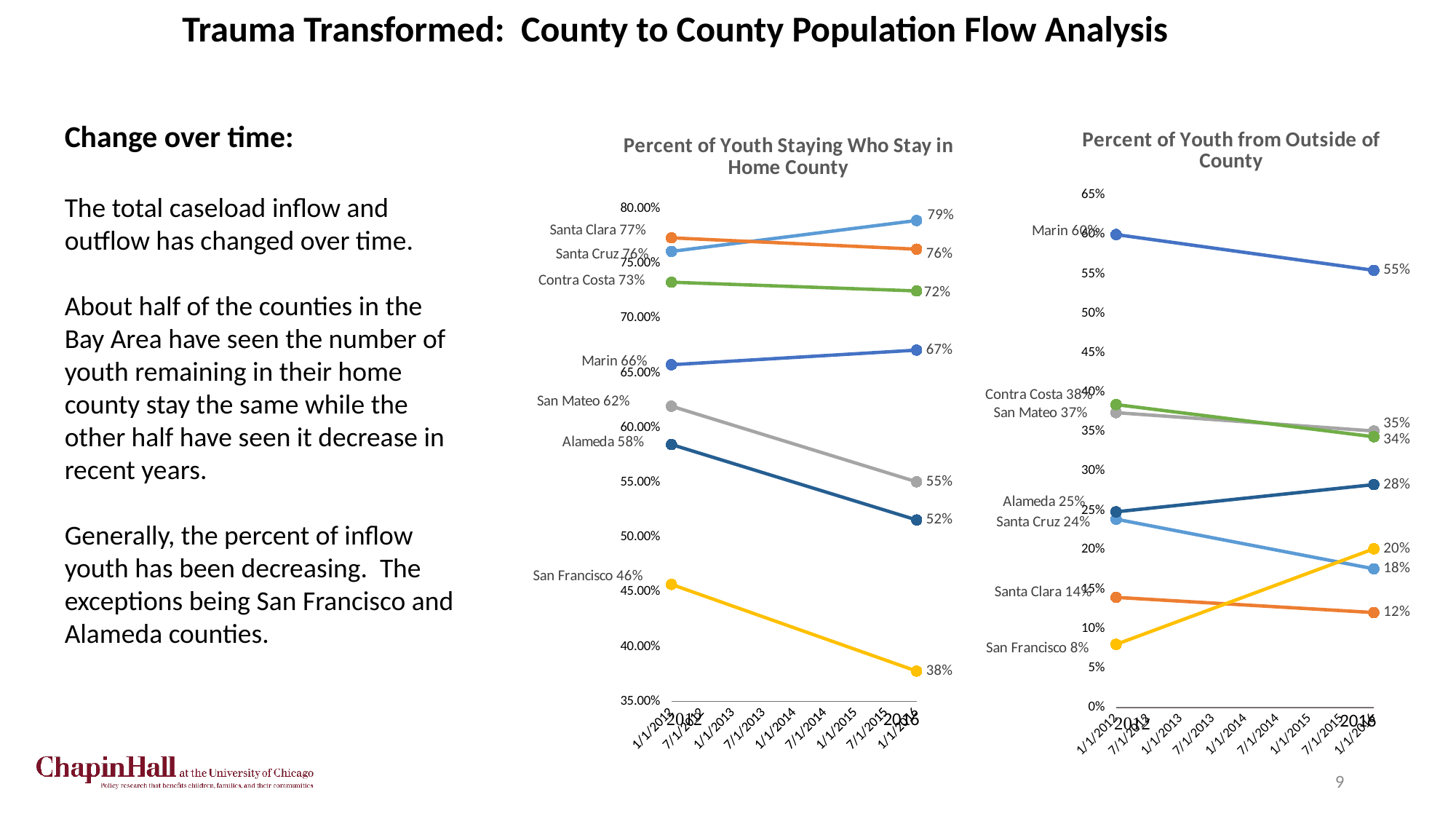
In the left chart, 'Percent of Youth Staying Who Stay in Home County', which county has the highest value in 2012? Santa Clara How many counties are plotted in the right chart, 'Percent of Youth from Outside of County'? 7 What kind of chart is the left chart, 'Percent of Youth Staying Who Stay in Home County'? line chart In the left chart, 'Percent of Youth Staying Who Stay in Home County', which county has the lowest value in 2012? San Francisco In the right chart, 'Percent of Youth from Outside of County', what is the value for San Francisco in 2012? 8% In the left chart, 'Percent of Youth Staying Who Stay in Home County', what is the value for San Francisco in 2012? 46% In the left chart, 'Percent of Youth Staying Who Stay in Home County', what is the value for Santa Clara in 2012? 77% In the left chart, 'Percent of Youth Staying Who Stay in Home County', what is the difference between San Mateo and Alameda in 2012? 4% In the right chart, 'Percent of Youth from Outside of County', does the Marin line rise or fall from 2012 to 2016? fall In the right chart, 'Percent of Youth from Outside of County', what is the value for Marin in 2012? 60% In the right chart, 'Percent of Youth from Outside of County', which is larger in 2012: Contra Costa or Santa Clara? Contra Costa In the left chart, 'Percent of Youth Staying Who Stay in Home County', does the San Francisco line rise or fall from 2012 to 2016? fall